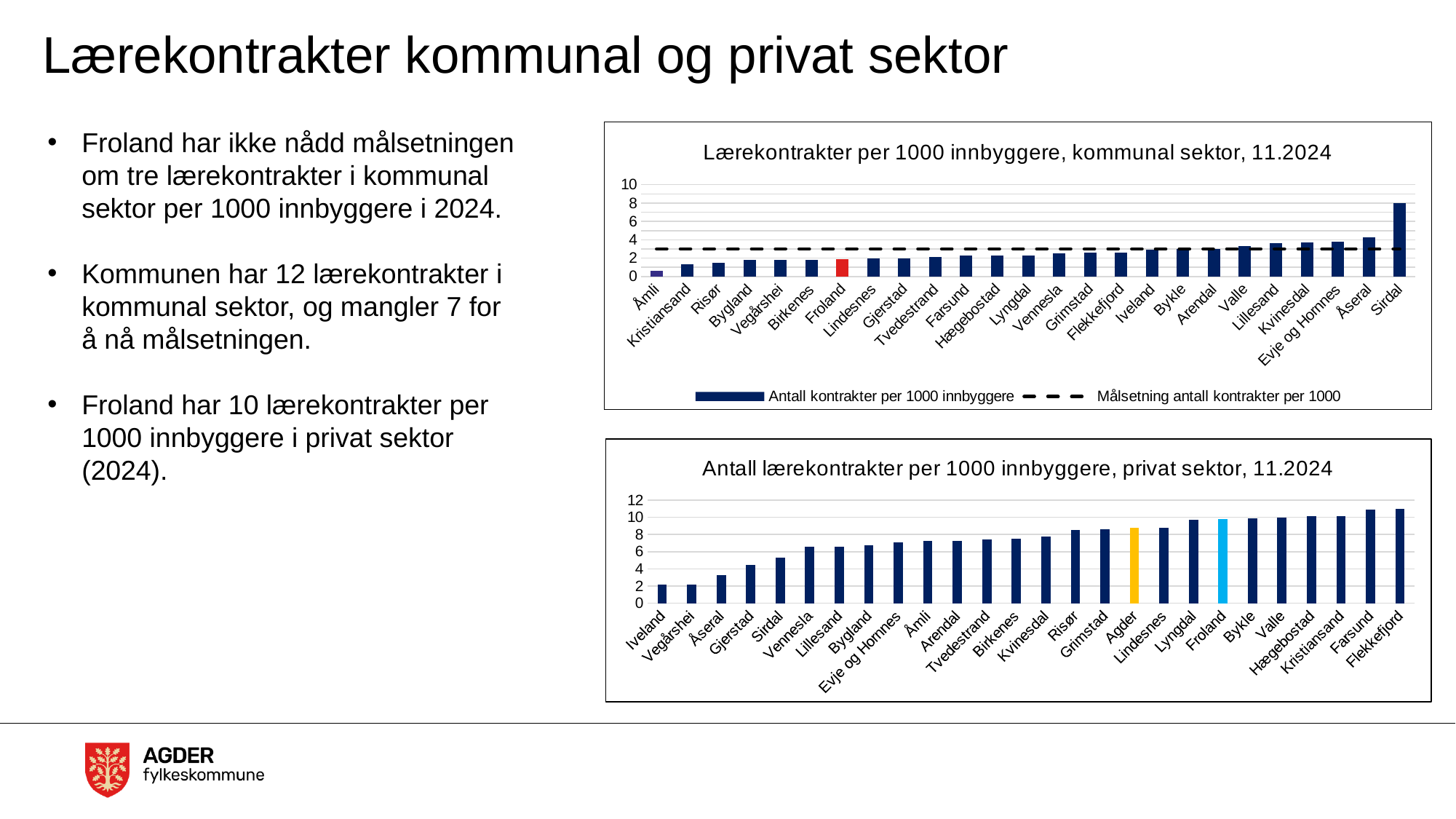
What kind of chart is the bottom chart (privat sektor)? bar chart In the bottom chart (privat sektor), is the value for Froland greater or less than 8? greater In the top chart (kommunal sektor), which municipality has the lowest value? Åmli How many municipalities are shown in the top chart (kommunal sektor)? 25 How many series does the legend of the top chart (kommunal sektor) list? 2 In the top chart (kommunal sektor), which municipality has the highest number of lærekontrakter per 1000 innbyggere? Sirdal In the top chart (kommunal sektor), do the bar values rise or fall from left to right? rise In the top chart (kommunal sektor), is the value for Froland greater or less than 4? less In the bottom chart (privat sektor), is the value for Iveland greater or less than 4? less What is the title of the bottom chart? Antall lærekontrakter per 1000 innbyggere, privat sektor, 11.2024 In the bottom chart (privat sektor), which is larger, the value for Gjerstad or the value for Sirdal? Sirdal